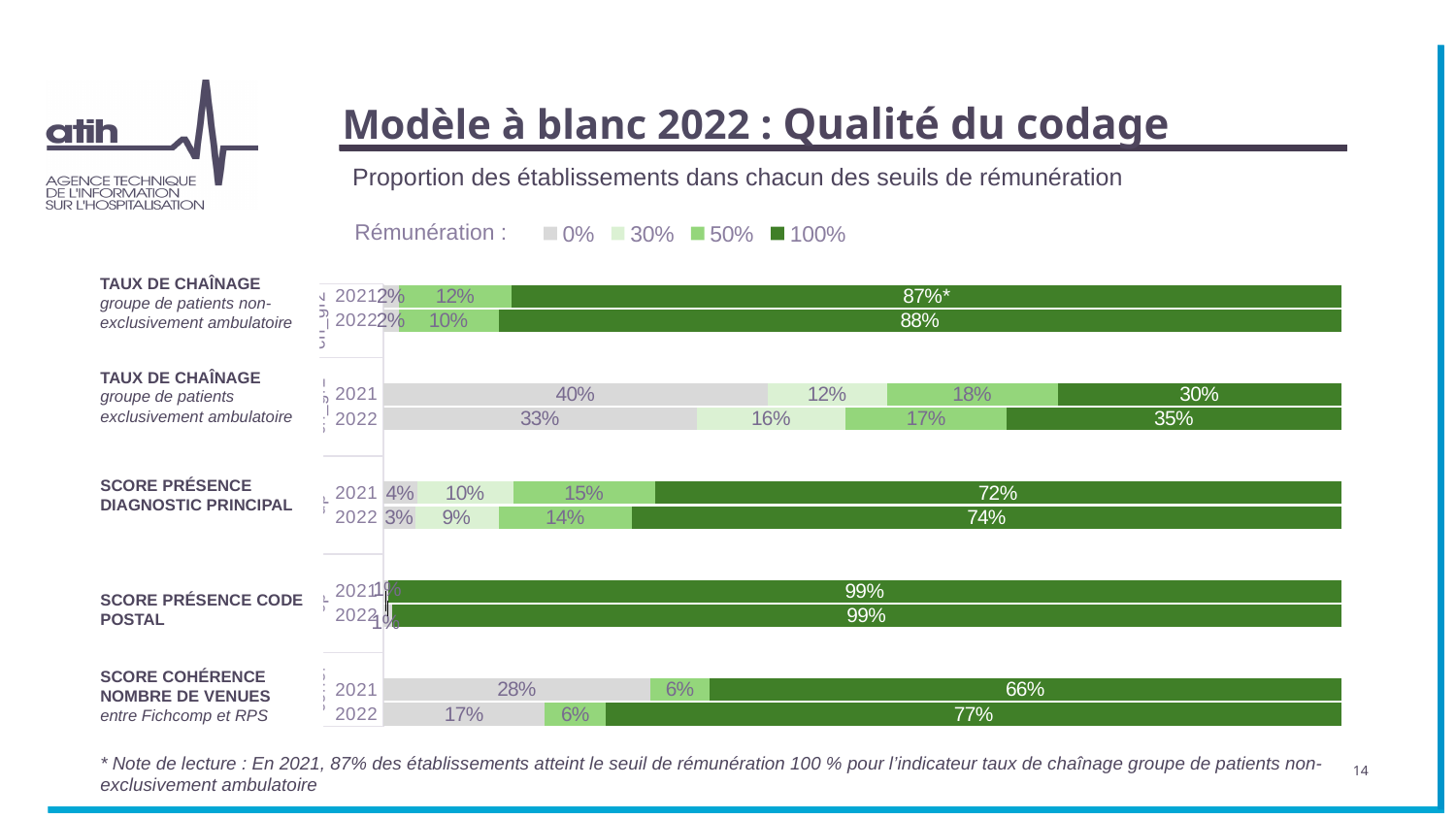
For 'Score cohérence nombre de venues', what is the 0% threshold value in 2021? 28% For 'Taux de chaînage groupe de patients exclusivement ambulatoire' in 2021, what is the difference between the 0% threshold value and the 100% threshold value? 10 percentage points For 'Taux de chaînage groupe de patients exclusivement ambulatoire' in 2022, what proportion of establishments is in the 100% remuneration threshold? 35% For 'Score présence diagnostic principal', what is the 100% threshold value in 2022? 74% What kind of chart is shown on the slide? stacked bar chart What are the legend entries of the chart? 0%, 30%, 50%, 100% For 'Score cohérence nombre de venues', by how many percentage points did the 100% threshold value change from 2021 to 2022? 11 percentage points (66% to 77%) Which indicator has the highest proportion of establishments at the 100% threshold in 2022? Score présence code postal How many series does the legend list? 4 For 'Taux de chaînage groupe de patients exclusivement ambulatoire' in 2021, what proportion of establishments is in the 0% remuneration threshold? 40% For 'Taux de chaînage groupe de patients non-exclusivement ambulatoire', which year has the larger 100% threshold value, 2021 or 2022? 2022 For 'Score présence code postal', what proportion of establishments reached the 100% threshold in 2021? 99%